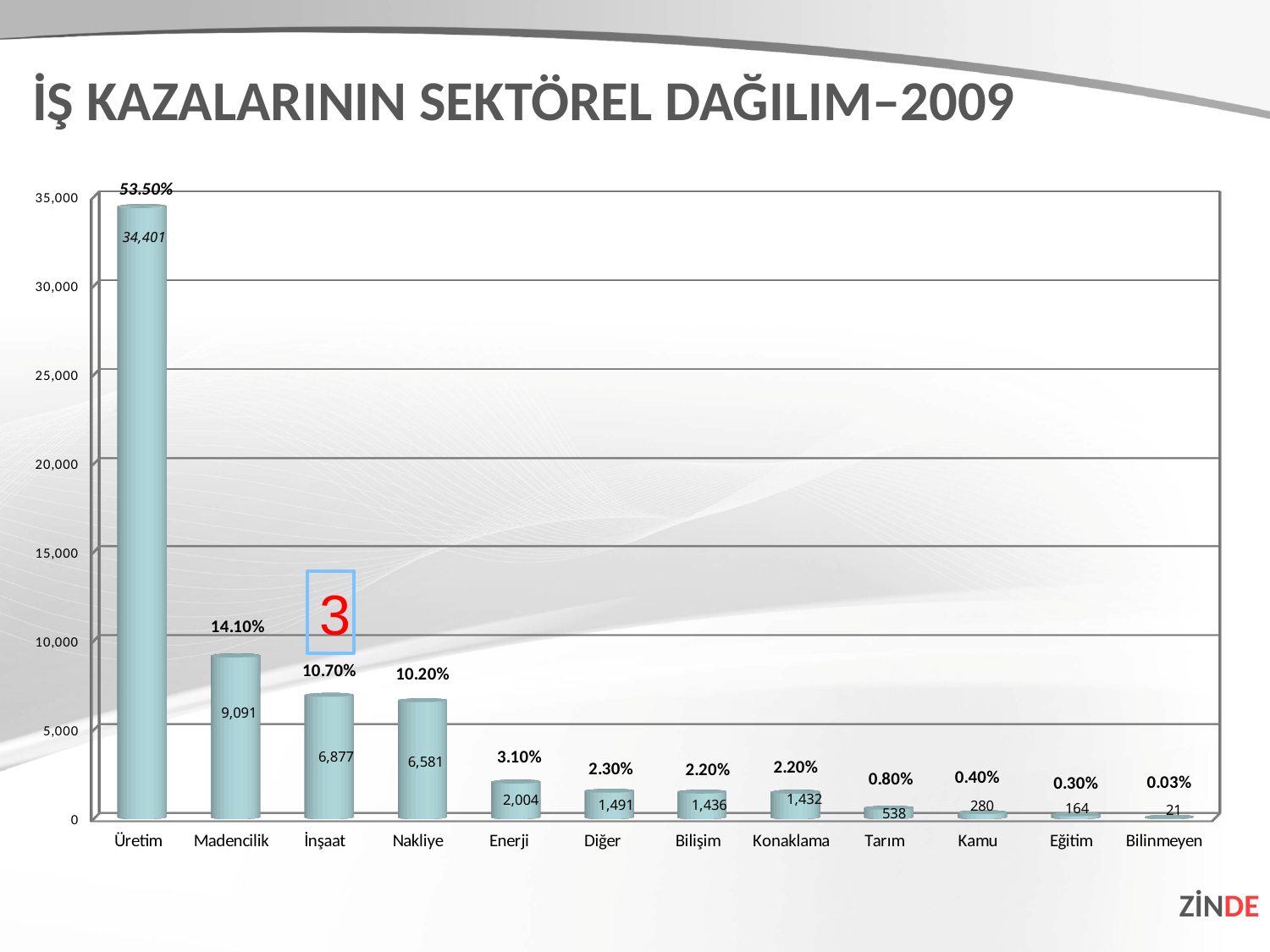
What is the value shown for Üretim? 34,401 How many categories are shown on the x axis? 12 What is the value shown for Bilinmeyen? 21 What kind of chart is shown on the slide? bar chart What is the value shown for Nakliye? 6,581 Is the value for Madencilik greater or less than 10,000? less Which is larger, the value for Enerji or the value for Diğer? Enerji Which category has the highest value? Üretim What is the difference between the values for Madencilik and İnşaat? 2,214 Which category has the lowest value? Bilinmeyen What percentage is shown above the Madencilik bar? 14.10% What is the title of the slide? İŞ KAZALARININ SEKTÖREL DAĞILIM–2009